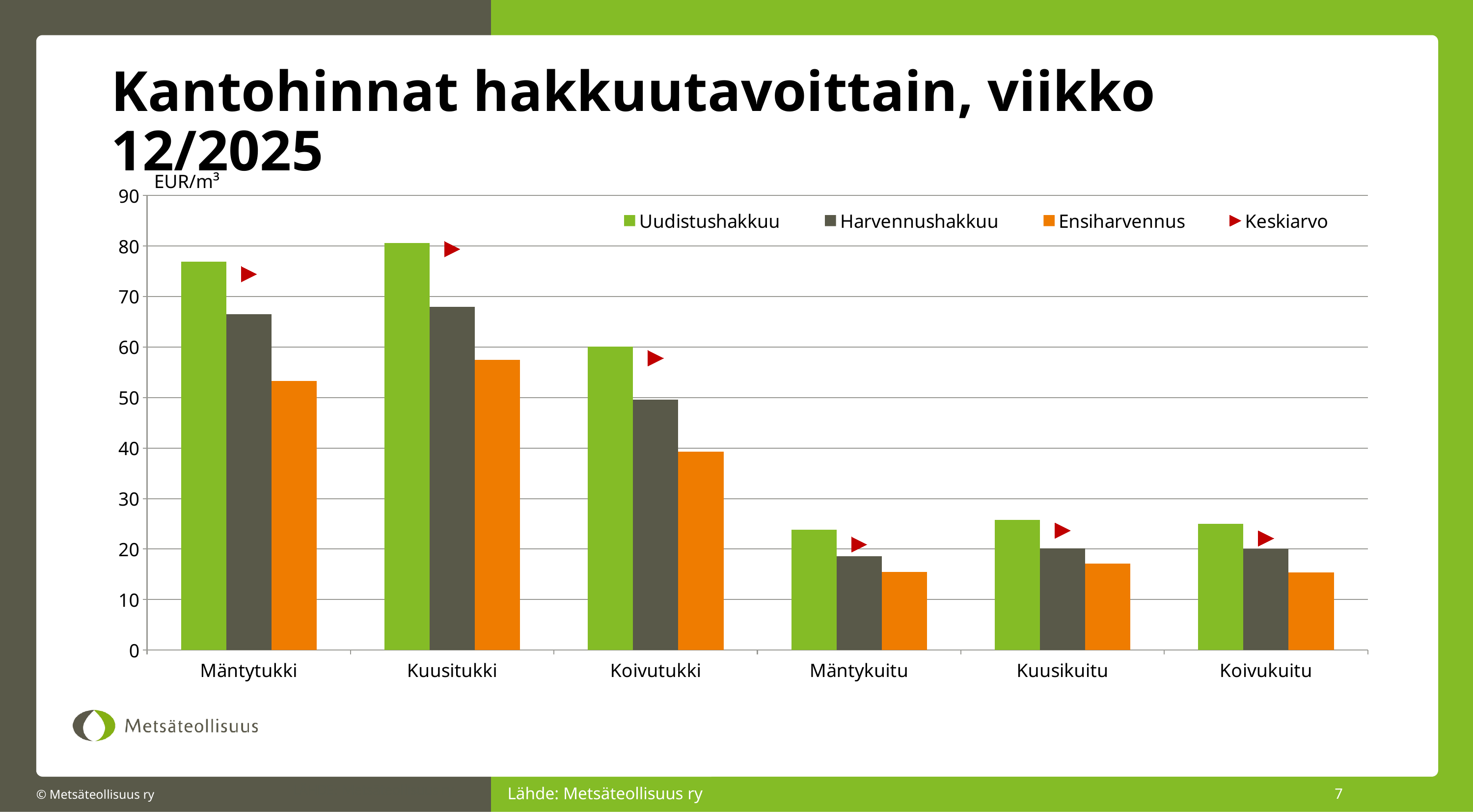
Which is larger, the Uudistushakkuu value for Mäntytukki or for Kuusitukki? Kuusitukki Is the Ensiharvennus value for Mäntytukki greater or less than 50? greater How many series does the legend list? 4 How many categories are shown on the x axis? 6 Is the Uudistushakkuu value for Kuusitukki greater or less than 70? greater Which category has the highest Uudistushakkuu value? Kuusitukki Is the Ensiharvennus value for Kuusikuitu greater or less than 20? less Which is larger, the Harvennushakkuu value for Mäntytukki or for Koivutukki? Mäntytukki Among Mäntytukki, Kuusitukki and Koivutukki, which has the lowest Ensiharvennus value? Koivutukki What kind of chart is shown on the slide? bar chart What unit is shown on the y axis of the chart? EUR/m³